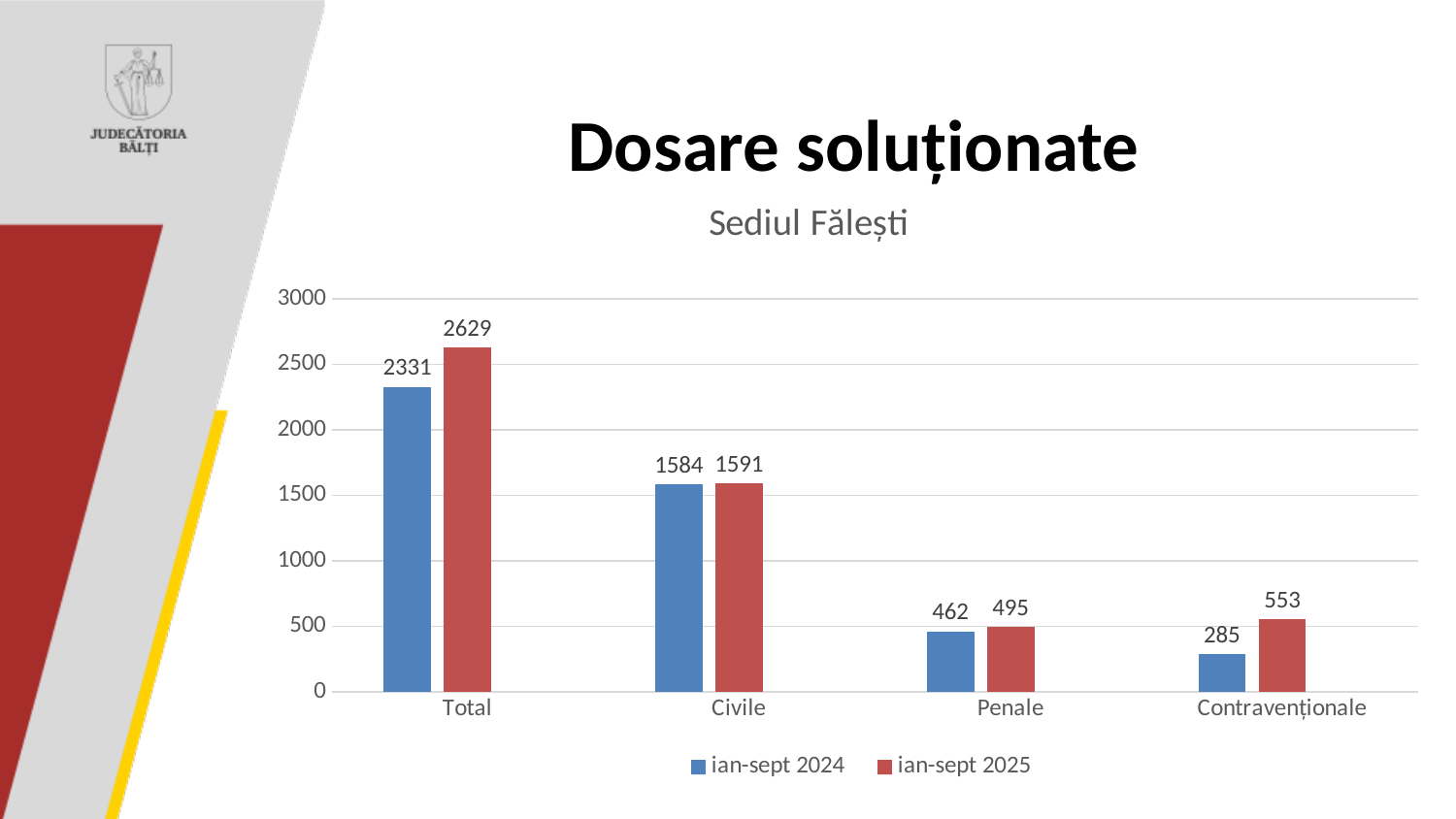
What is the value for Contravenționale in the ian-sept 2025 series? 553 How many series does the legend list? 2 How many categories are shown on the x axis? 4 Which category has the lowest value in the ian-sept 2024 series? Contravenționale What is the difference between the ian-sept 2025 and ian-sept 2024 values for Total? 298 What is the value for Total in the ian-sept 2025 series? 2629 Which category has the highest value in the ian-sept 2025 series? Total What kind of chart is shown on the slide? bar chart What is the difference between the ian-sept 2025 and ian-sept 2024 values for Contravenționale? 268 What is the value for Penale in the ian-sept 2024 series? 462 What is the title of the chart? Sediul Fălești Which is larger for Penale: the ian-sept 2024 value or the ian-sept 2025 value? ian-sept 2025